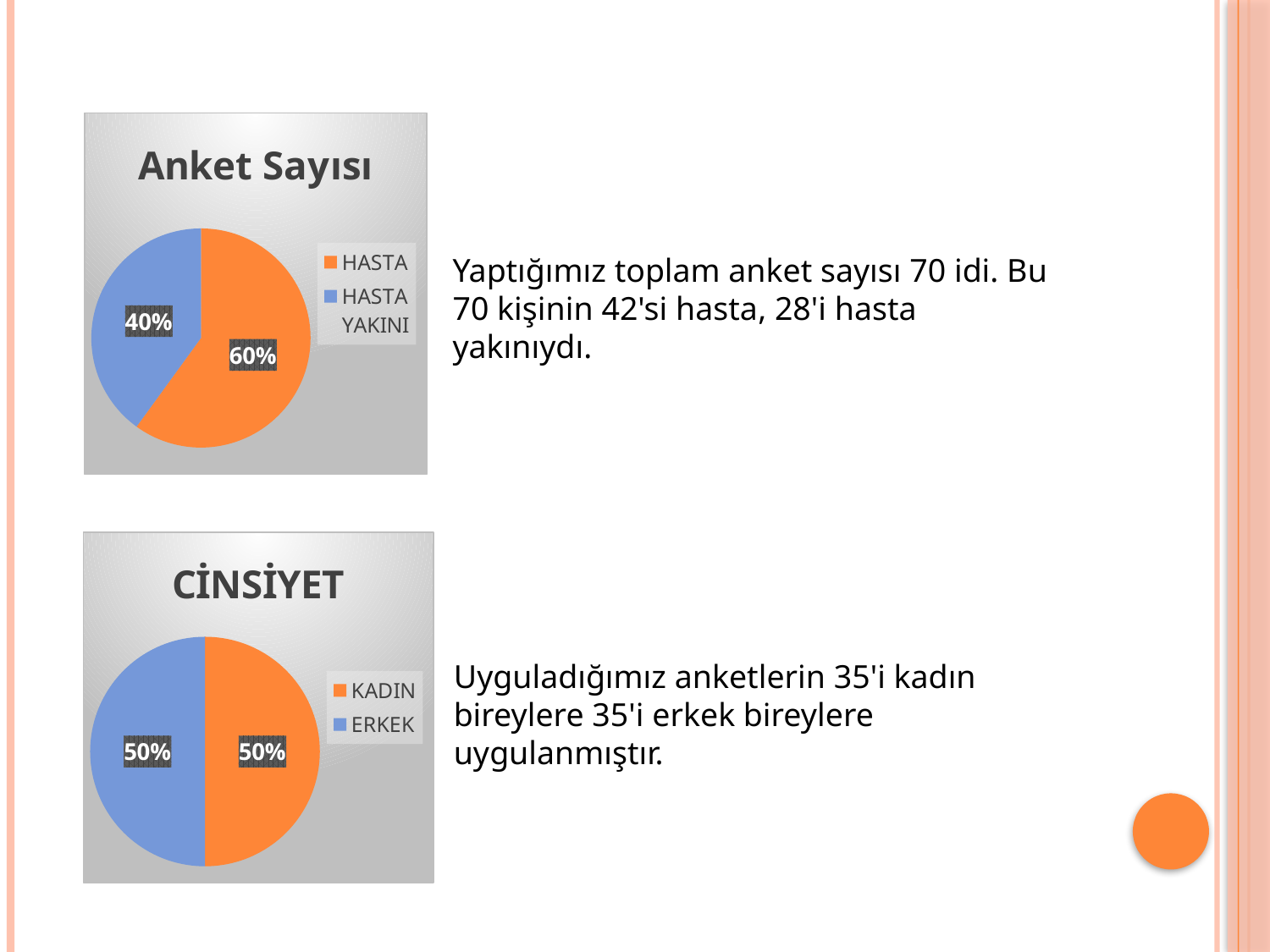
In the "Anket Sayısı" chart, how many slices does the pie have? 2 In the "Anket Sayısı" chart, which is larger, HASTA or HASTA YAKINI? HASTA In the "Anket Sayısı" chart, which slice is the smallest? HASTA YAKINI In the "CİNSİYET" chart, what share of the pie is ERKEK? 50% In the "Anket Sayısı" chart, what is the difference in percentage points between the HASTA and HASTA YAKINI slices? 20 percentage points What kind of chart is the "Anket Sayısı" chart? Pie chart In the "Anket Sayısı" chart, which slice is the largest? HASTA In the "CİNSİYET" chart, what colour is the KADIN slice? Orange In the "CİNSİYET" chart, what share of the pie is KADIN? 50% In the "Anket Sayısı" chart, what share of the pie is HASTA? 60% In the "CİNSİYET" chart, how many entries does the legend list? 2